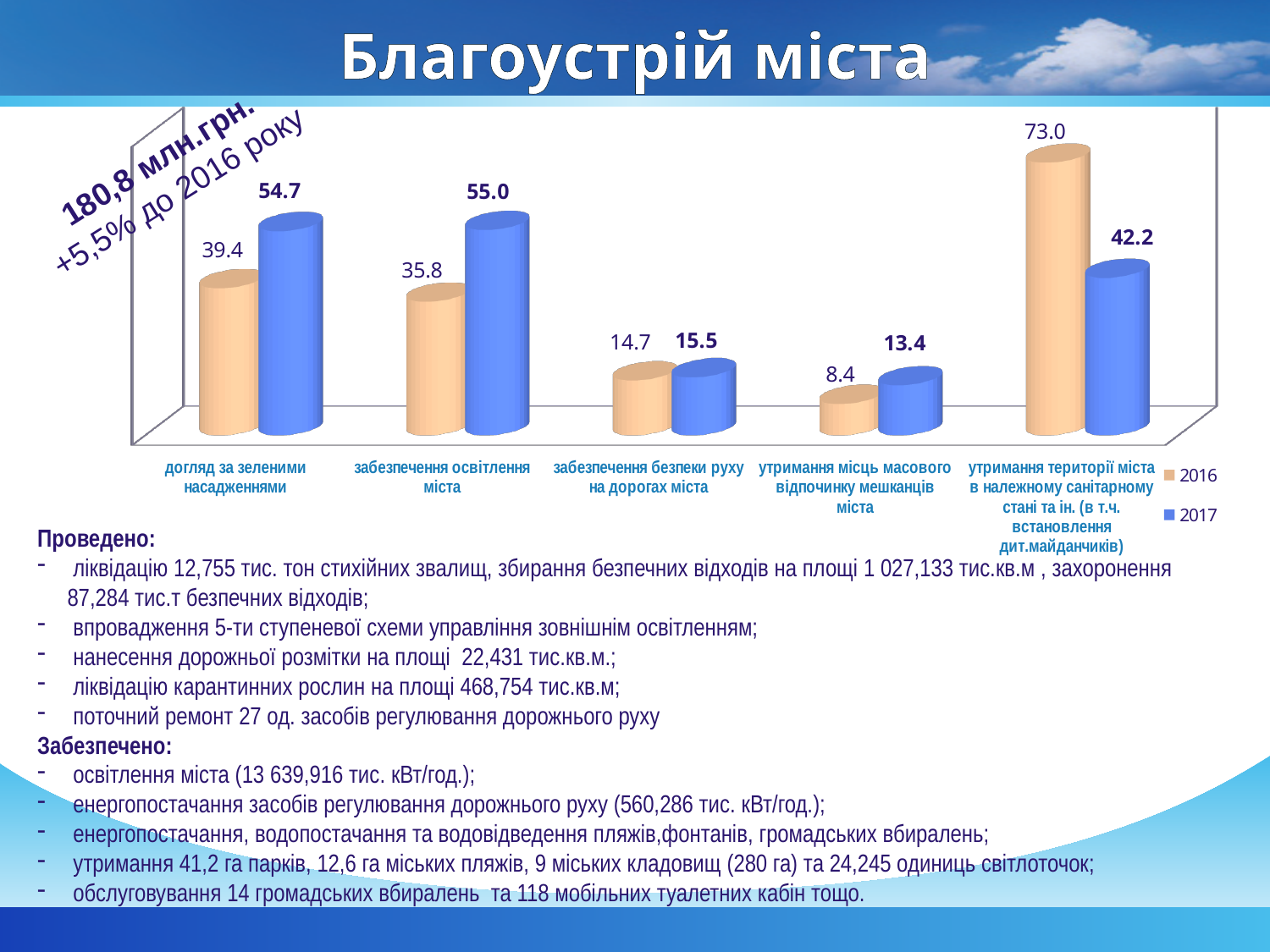
Which colour represents the 2017 series in the chart? blue What is the 2016 value for "забезпечення освітлення міста"? 35.8 Which is larger for "забезпечення освітлення міста": the 2016 value or the 2017 value? 2017 What is the difference between the 2017 and 2016 values for "забезпечення безпеки руху на дорогах міста"? 0.8 What is the 2016 value for "утримання місць масового відпочинку мешканців міста"? 8.4 What is the 2017 value for "догляд за зеленими насадженнями"? 54.7 What is the difference between the 2016 and 2017 values for "утримання території міста в належному санітарному стані та ін."? 30.8 How many categories are shown on the x axis of the chart? 5 How many series does the chart legend list? 2 What type of chart is shown on the slide? bar chart Which category has the lowest 2017 value? утримання місць масового відпочинку мешканців міста Which category has the highest 2016 value? утримання території міста в належному санітарному стані та ін.